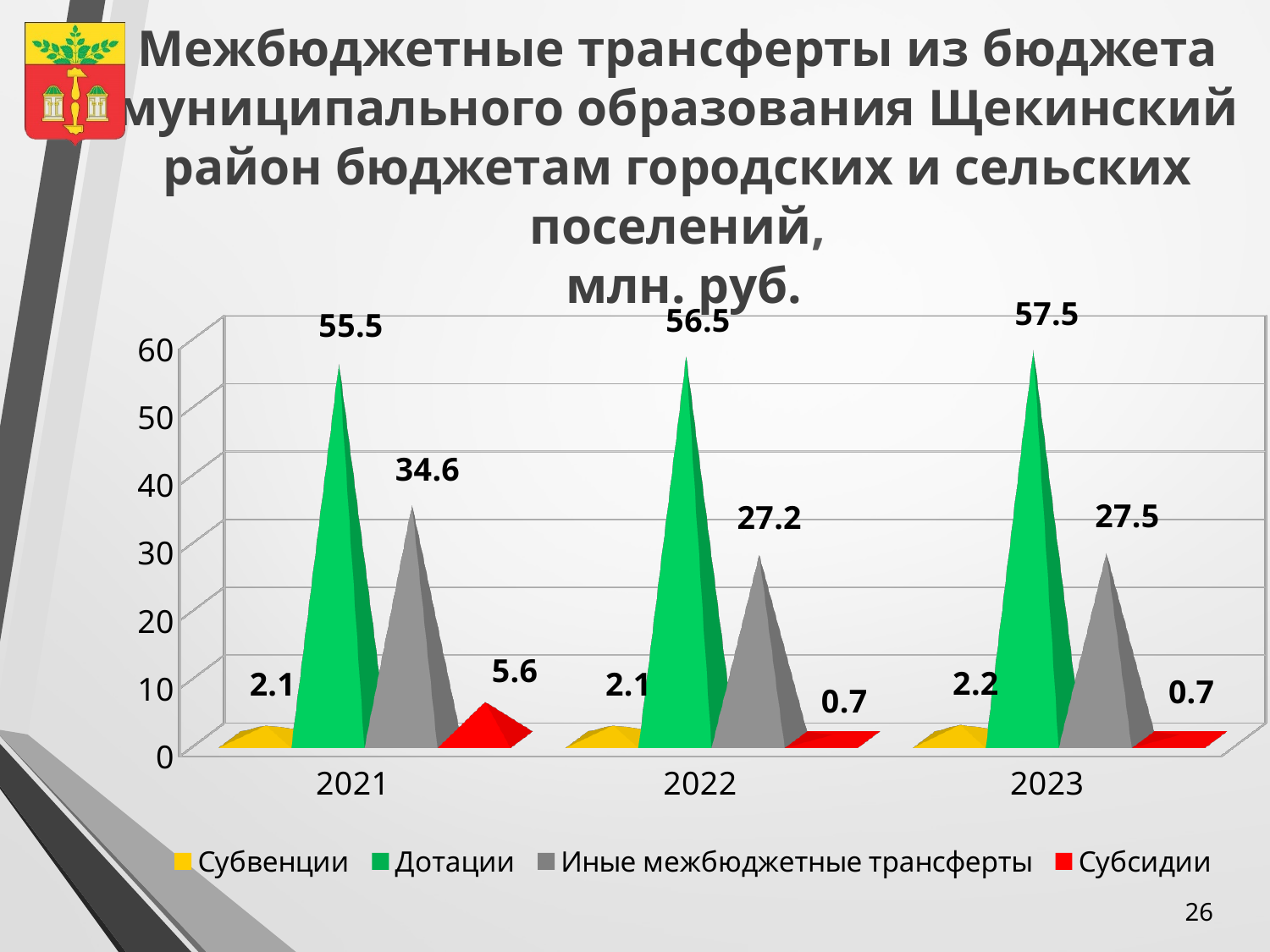
What is the value for Субвенции in 2023? 2.2 How many years are shown on the x axis? 3 In which year is the value for Иные межбюджетные трансферты the lowest? 2022 Which is larger in 2021: Иные межбюджетные трансферты or Субсидии? Иные межбюджетные трансферты What kind of chart is shown on the slide? bar chart What is the value for Субсидии in 2021? 5.6 What is the difference between the Дотации values for 2023 and 2021? 2.0 What is the value for Иные межбюджетные трансферты in 2022? 27.2 In which year is the value for Дотации the highest? 2023 Do the values for Дотации rise or fall from 2021 to 2023? rise How many series does the legend list? 4 What is the value for Дотации in 2021? 55.5